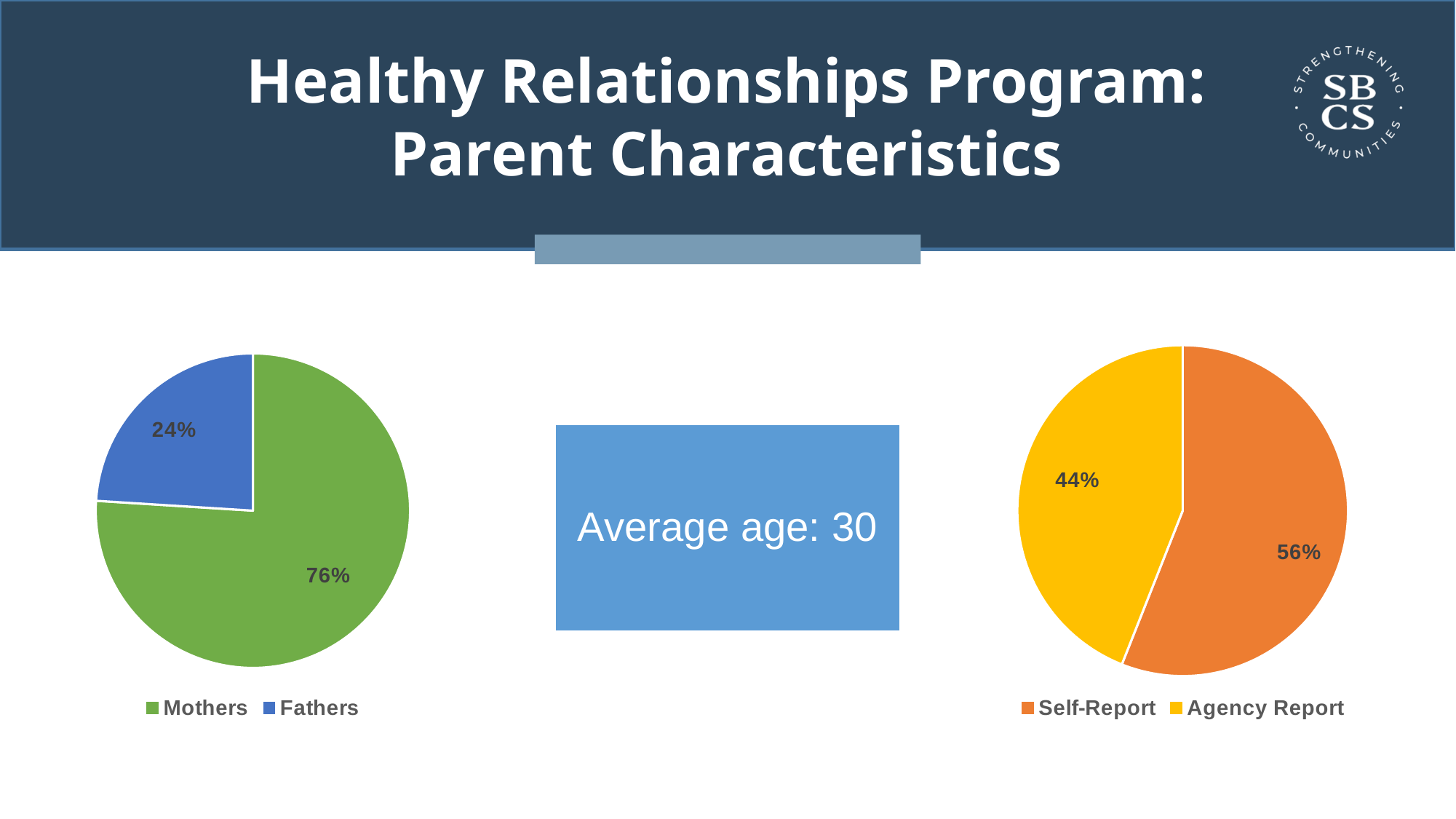
In the right pie chart, what share is labelled for Agency Report? 44% In the left pie chart, what is the difference in percentage points between Mothers and Fathers? 52 In the right pie chart, which is larger, Self-Report or Agency Report? Self-Report In the right pie chart, what share is labelled for Self-Report? 56% In the left pie chart, what colour is the Fathers slice? Blue How many entries does the legend of the right pie chart list? 2 In the right pie chart, which category has the smallest slice? Agency Report In the left pie chart, what share is labelled for Fathers? 24% In the left pie chart, which category has the largest slice? Mothers What kind of chart is the chart on the left of the slide? Pie chart In the right pie chart, what is the difference in percentage points between Self-Report and Agency Report? 12 In the left pie chart, what share is labelled for Mothers? 76%